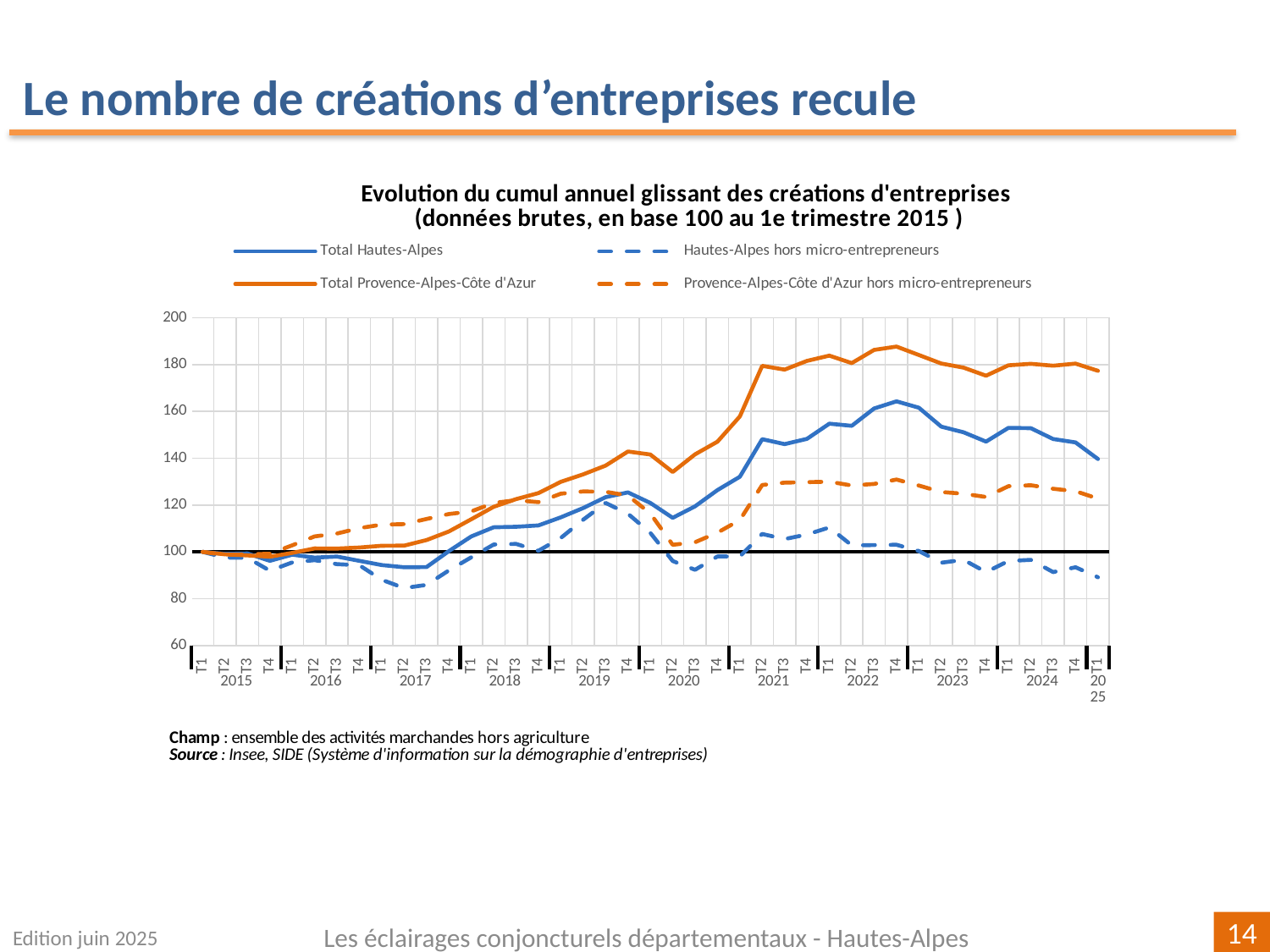
What is the base value of the index at the first quarter of 2015, according to the chart title? 100 Is the value for Hautes-Alpes hors micro-entrepreneurs at T1 2025 greater or less than 100? less Is the value for Total Hautes-Alpes at T1 2025 greater or less than 120? greater Which series has the lowest value at T1 2025? Hautes-Alpes hors micro-entrepreneurs At T1 2025, which is larger: Total Provence-Alpes-Côte d'Azur or Total Hautes-Alpes? Total Provence-Alpes-Côte d'Azur How many series does the legend list? 4 Is the value for Total Provence-Alpes-Côte d'Azur at T1 2025 greater or less than 160? greater What kind of chart is shown on the slide? line chart Which series has the highest value at T1 2025? Total Provence-Alpes-Côte d'Azur Which series is drawn as a solid orange line? Total Provence-Alpes-Côte d'Azur Does the Total Hautes-Alpes series rise or fall between T4 2022 and T1 2025? fall